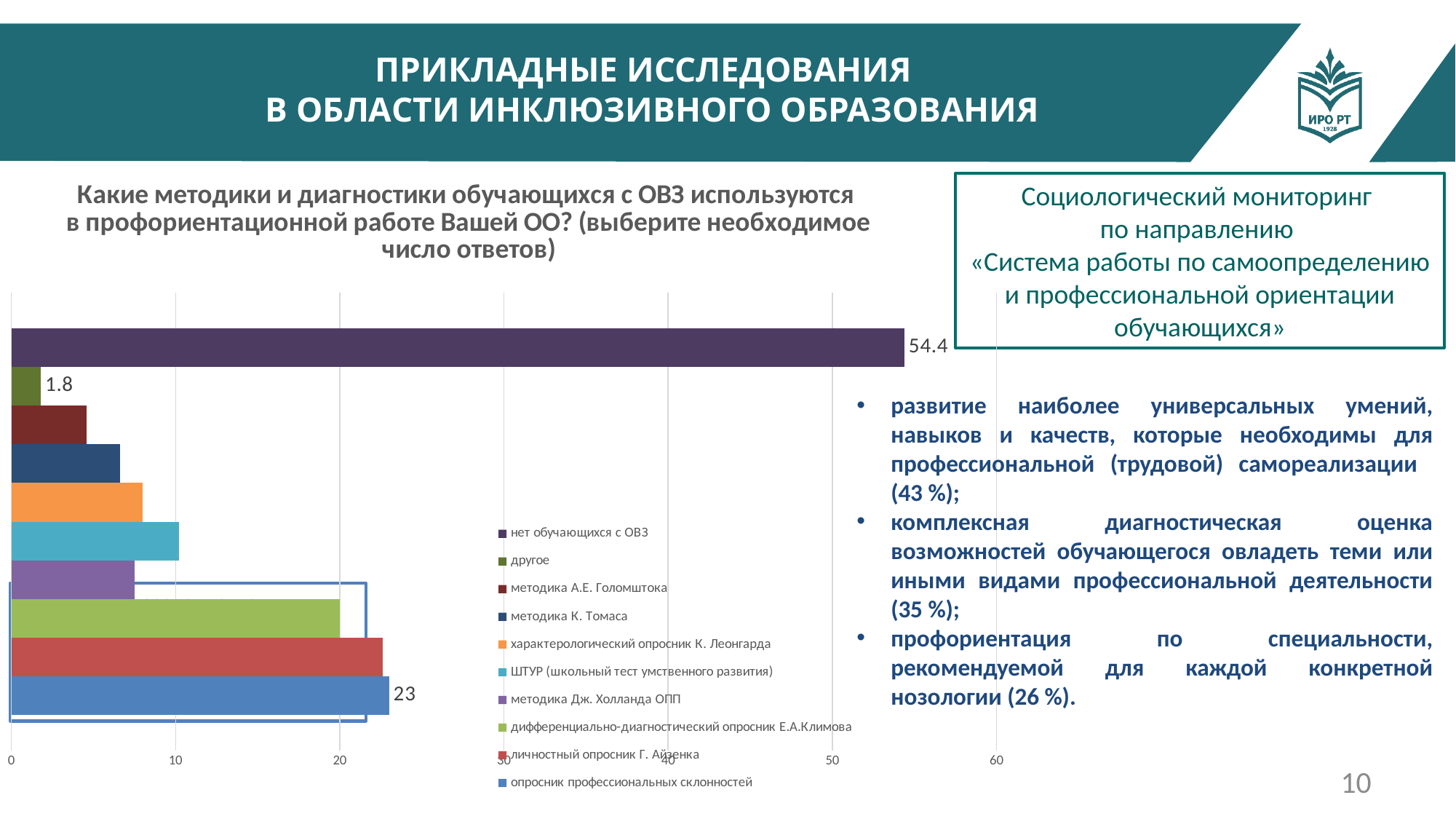
What kind of chart is shown on the slide? bar chart Which category has the lowest value? другое What is the difference between the values for «нет обучающихся с ОВЗ» and «опросник профессиональных склонностей»? 31.4 Is the value for «ШТУР (школьный тест умственного развития)» greater or less than 20? less Which category has the highest value? нет обучающихся с ОВЗ How many entries does the legend list? 10 Which is larger: the value for «нет обучающихся с ОВЗ» or for «опросник профессиональных склонностей»? нет обучающихся с ОВЗ Is the value for «методика К. Томаса» greater or less than 10? less What is the value for «другое»? 1.8 What is the value for «нет обучающихся с ОВЗ»? 54.4 What is the difference between the values for «опросник профессиональных склонностей» and «другое»? 21.2 What is the value for «опросник профессиональных склонностей»? 23